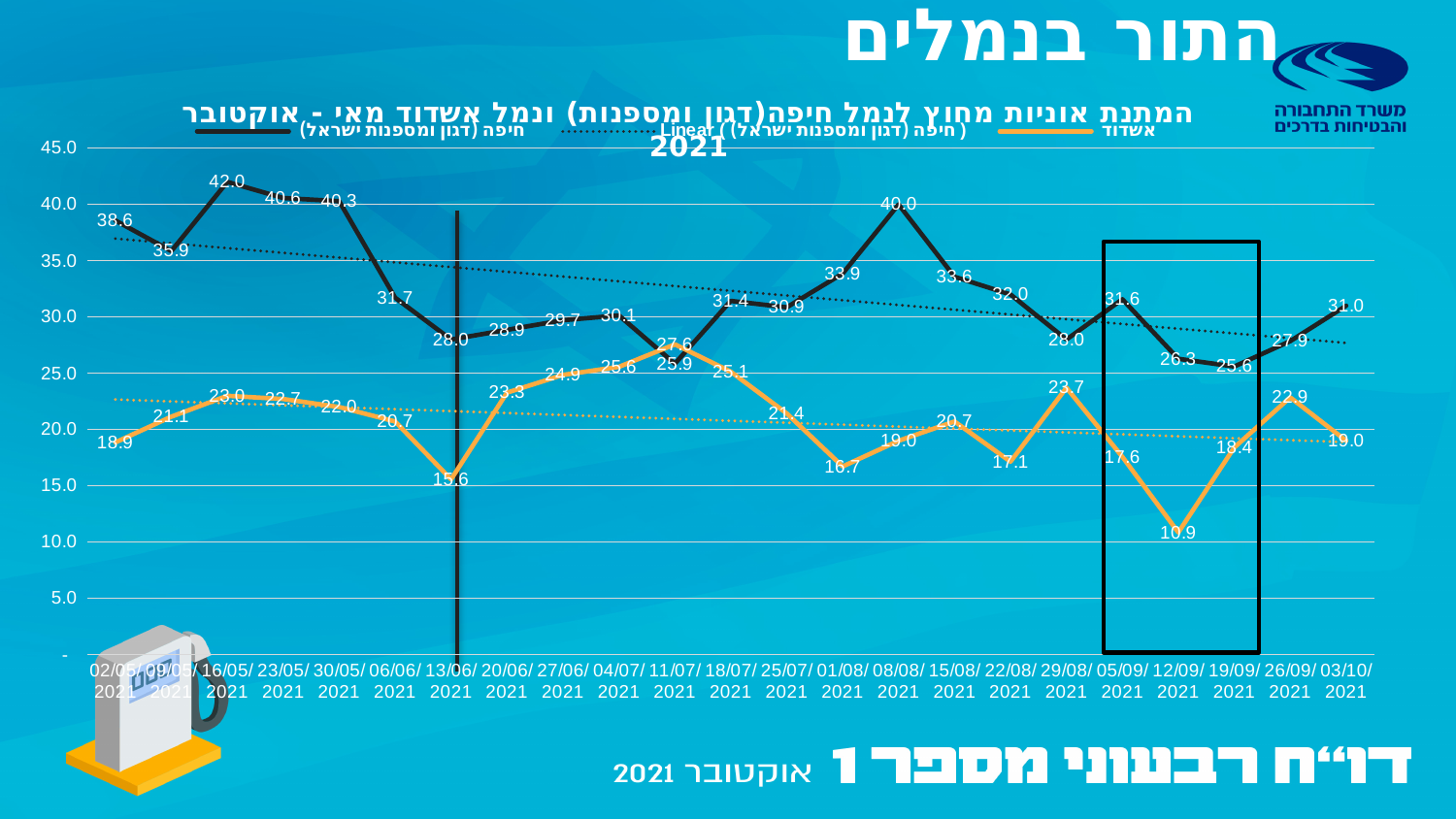
On which date does the Haifa (חיפה) series reach its highest value? 16/05/2021 What is the value for Haifa (חיפה) on 03/10/2021? 31.0 What colour is the line for the Ashdod (אשדוד) series? orange What is the value for Ashdod (אשדוד) on 12/09/2021? 10.9 On which date does the Ashdod (אשדוד) series reach its lowest value? 12/09/2021 On 08/08/2021, which series has the larger value, Haifa or Ashdod? Haifa (חיפה) What is the value for Haifa (חיפה) on 16/05/2021? 42.0 How many dates are plotted along the x axis? 23 What is the difference between the Haifa and Ashdod values on 13/06/2021? 12.4 On which date does the Haifa (חיפה) series reach its lowest value? 19/09/2021 What is the value for Ashdod (אשדוד) on 02/05/2021? 18.9 What kind of chart is shown on the slide? line chart